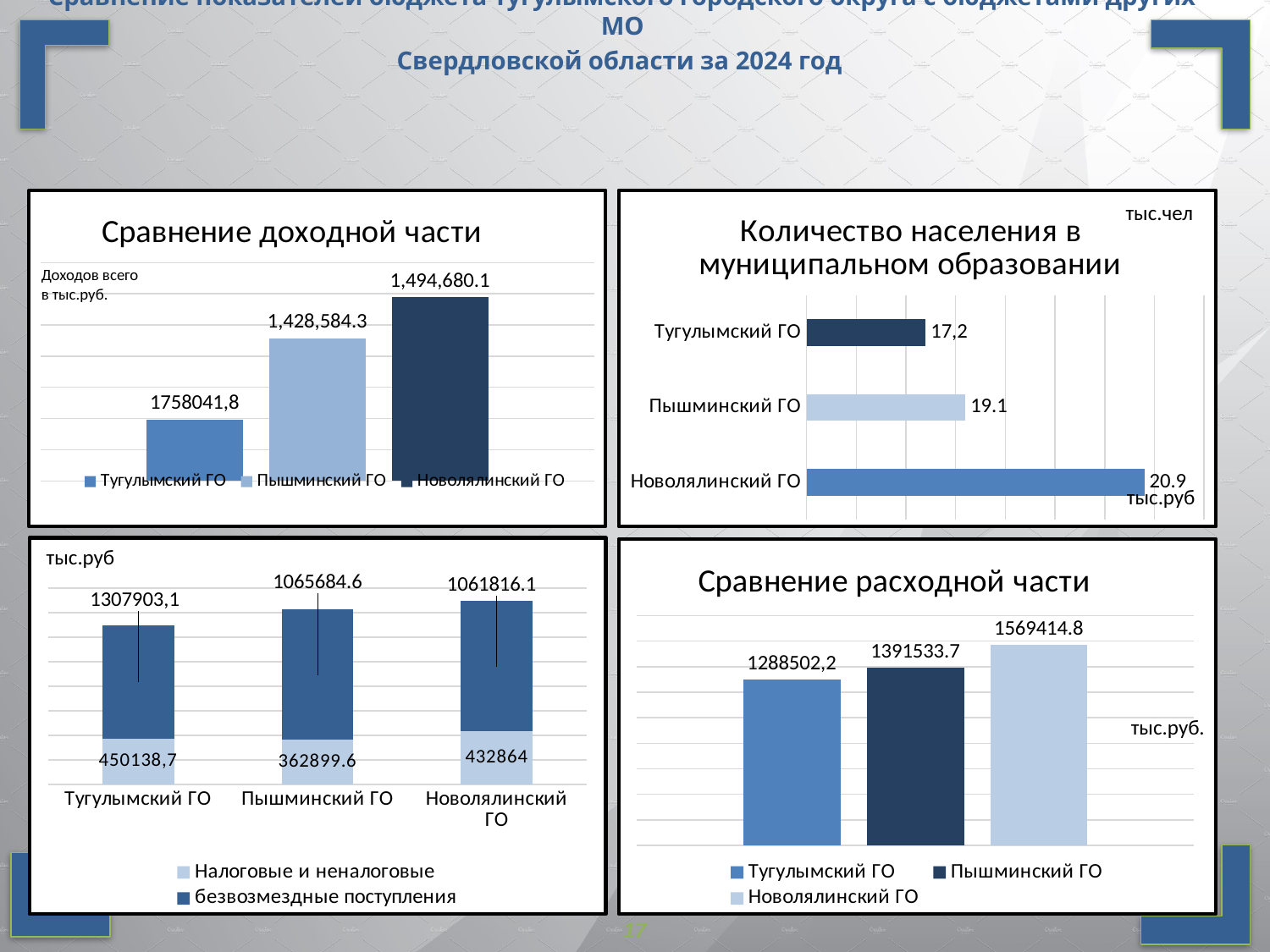
In the stacked bar chart at the bottom left, what is the value of 'Налоговые и неналоговые' for Пышминский ГО? 362899.6 In the stacked bar chart at the bottom left, how many series does the legend list? 2 In the chart titled 'Сравнение доходной части', which is larger, the value for Пышминский ГО or Новолялинский ГО? Новолялинский ГО In the chart titled 'Сравнение доходной части', what is the value for Новолялинский ГО? 1,494,680.1 In the chart titled 'Сравнение расходной части', which municipality has the lowest value? Тугулымский ГО In the stacked bar chart at the bottom left, what is the total of the stacked bar for Новолялинский ГО? 1494680.1 In the chart titled 'Сравнение доходной части', what is the value for Пышминский ГО? 1,428,584.3 In the chart titled 'Количество населения в муниципальном образовании', what is the difference between the values for Новолялинский ГО and Тугулымский ГО? 3.7 In the chart titled 'Количество населения в муниципальном образовании', which municipality has the highest population? Новолялинский ГО What kind of chart is the chart titled 'Количество населения в муниципальном образовании'? Bar chart In the chart titled 'Количество населения в муниципальном образовании', what is the value for Пышминский ГО? 19.1 In the chart titled 'Сравнение расходной части', what is the difference between the values for Новолялинский ГО and Пышминский ГО? 177881.1